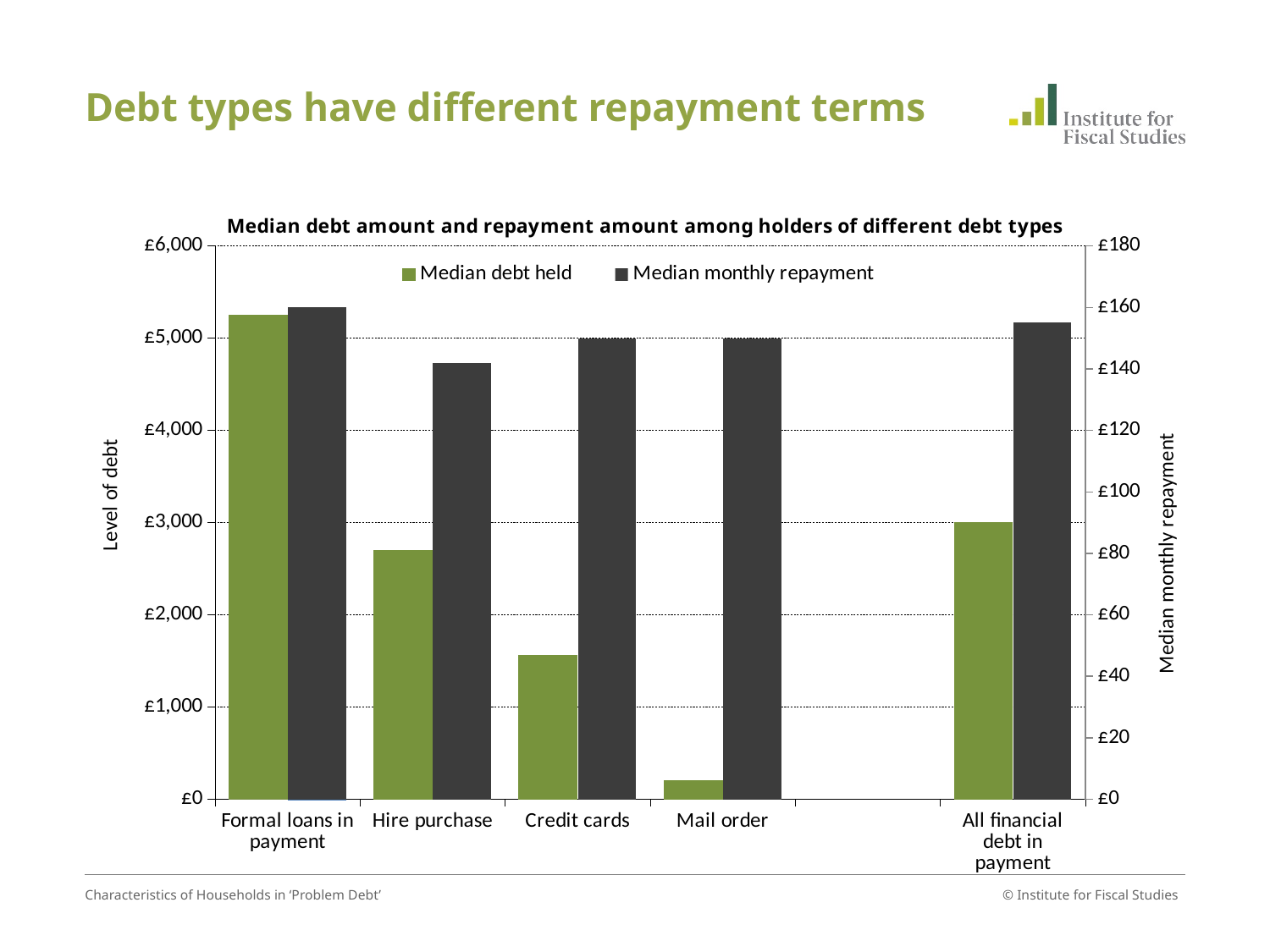
What is the title of the chart? Median debt amount and repayment amount among holders of different debt types Which debt type has the lowest median monthly repayment? Hire purchase How many debt type categories are shown on the x axis? 5 What is the label of the right-hand vertical axis? Median monthly repayment What type of chart is shown on the slide? bar chart Which is larger: the median debt held for Credit cards or for Hire purchase? Hire purchase Is the median debt held for Hire purchase greater or less than £3,000? less Is the median debt held for Formal loans in payment greater or less than £5,000? greater Which debt type has the lowest median debt held? Mail order Which debt type has the highest median debt held? Formal loans in payment How many series does the legend list? 2